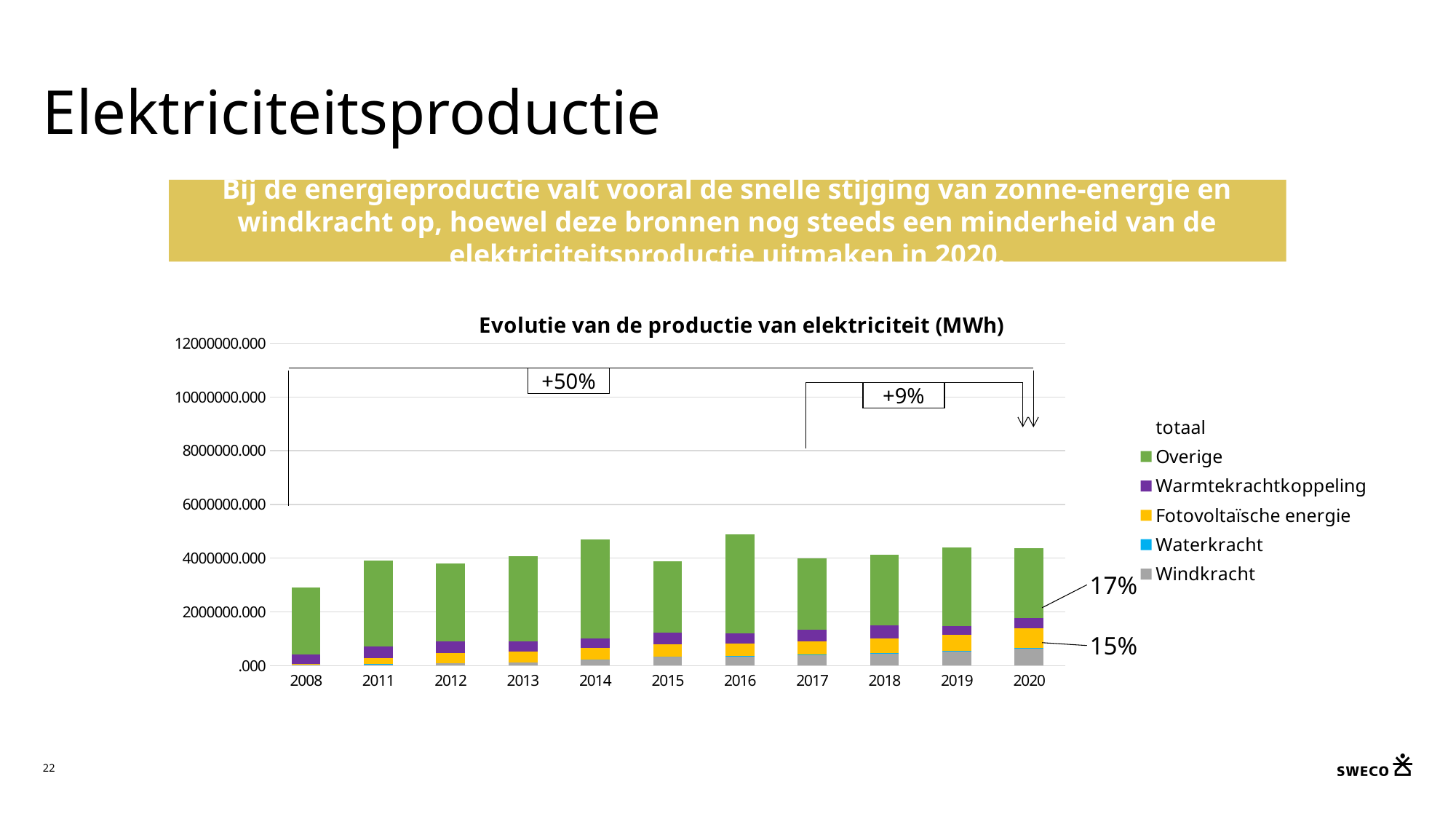
Which year has a larger total production, 2008 or 2011? 2011 Is the total production for 2008 greater or less than 4000000.000? less How many years (bars) are shown on the x axis of the chart? 11 Which year has the lowest total electricity production in the chart? 2008 Which year has a larger total production, 2016 or 2017? 2016 Does the total production rise or fall from 2017 to 2019? Rise What type of chart is shown on the slide? Stacked bar chart What is the title of the chart? Evolutie van de productie van elektriciteit (MWh) Is the total production for 2016 greater or less than 4000000.000? greater Which year has the highest total electricity production in the chart? 2016 What percentage increase is annotated for the period from 2008 to 2020 in the chart? +50% How many entries does the chart legend list? 6